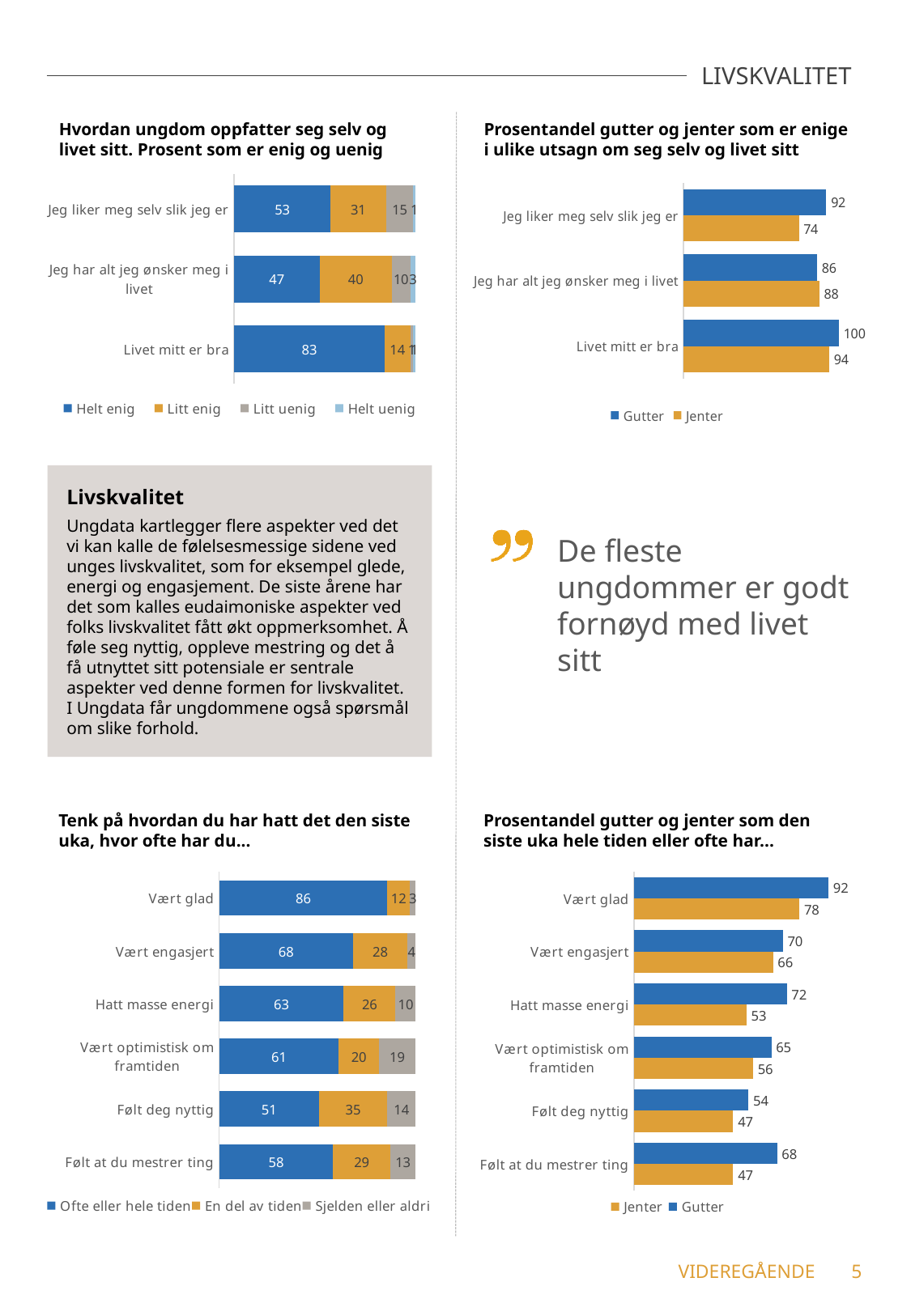
In the chart titled "Hvordan ungdom oppfatter seg selv og livet sitt", how many series does the legend list? 4 In the chart titled "Tenk på hvordan du har hatt det den siste uka, hvor ofte har du…", how many categories are shown? 6 In the chart titled "Hvordan ungdom oppfatter seg selv og livet sitt", what is the "Litt enig" value for "Jeg har alt jeg ønsker meg i livet"? 40 In the chart titled "Hvordan ungdom oppfatter seg selv og livet sitt", what is the "Helt enig" value for "Livet mitt er bra"? 83 What kind of chart is the one titled "Prosentandel gutter og jenter som den siste uka hele tiden eller ofte har…"? Bar chart In the chart titled "Prosentandel gutter og jenter som den siste uka hele tiden eller ofte har…", what is the value for Jenter on "Hatt masse energi"? 53 In the chart titled "Tenk på hvordan du har hatt det den siste uka, hvor ofte har du…", what is the "Sjelden eller aldri" value for "Vært optimistisk om framtiden"? 19 In the chart titled "Prosentandel gutter og jenter som er enige i ulike utsagn om seg selv og livet sitt", what is the difference between Gutter and Jenter for "Jeg liker meg selv slik jeg er"? 18 In the chart titled "Prosentandel gutter og jenter som er enige i ulike utsagn om seg selv og livet sitt", what is the value for Jenter on "Jeg liker meg selv slik jeg er"? 74 In the chart titled "Prosentandel gutter og jenter som den siste uka hele tiden eller ofte har…", which is larger for "Følt at du mestrer ting": Gutter or Jenter? Gutter In the chart titled "Tenk på hvordan du har hatt det den siste uka, hvor ofte har du…", which category has the lowest "Ofte eller hele tiden" value? Følt deg nyttig In the chart titled "Prosentandel gutter og jenter som er enige i ulike utsagn om seg selv og livet sitt", which category has the highest Gutter value? Livet mitt er bra